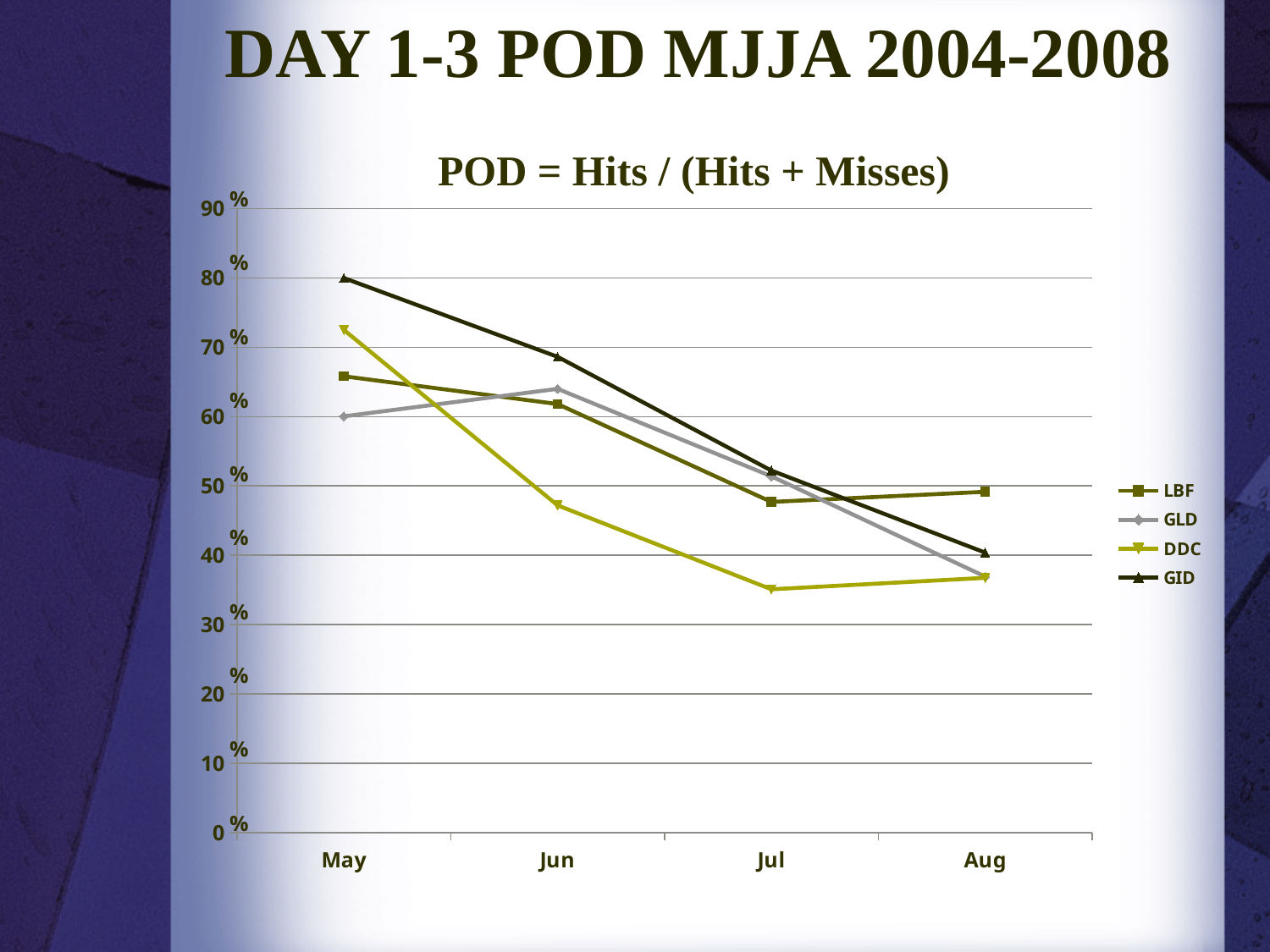
Which series has the lowest POD in Jul? DDC Which series has the highest POD in Aug? LBF How many months are shown along the x axis? 4 Is the value for LBF in Aug greater or less than 40%? greater Which series has the highest POD in May? GID How many series does the legend list? 4 In May, which is larger: the value for GID or the value for LBF? GID What kind of chart is shown on the slide? line chart Is the value for DDC in Jun greater or less than 50%? less What is the title shown above the chart? POD = Hits / (Hits + Misses) Is the value for GID in Jun greater or less than 60%? greater Does the GID line rise or fall from May to Aug? fall